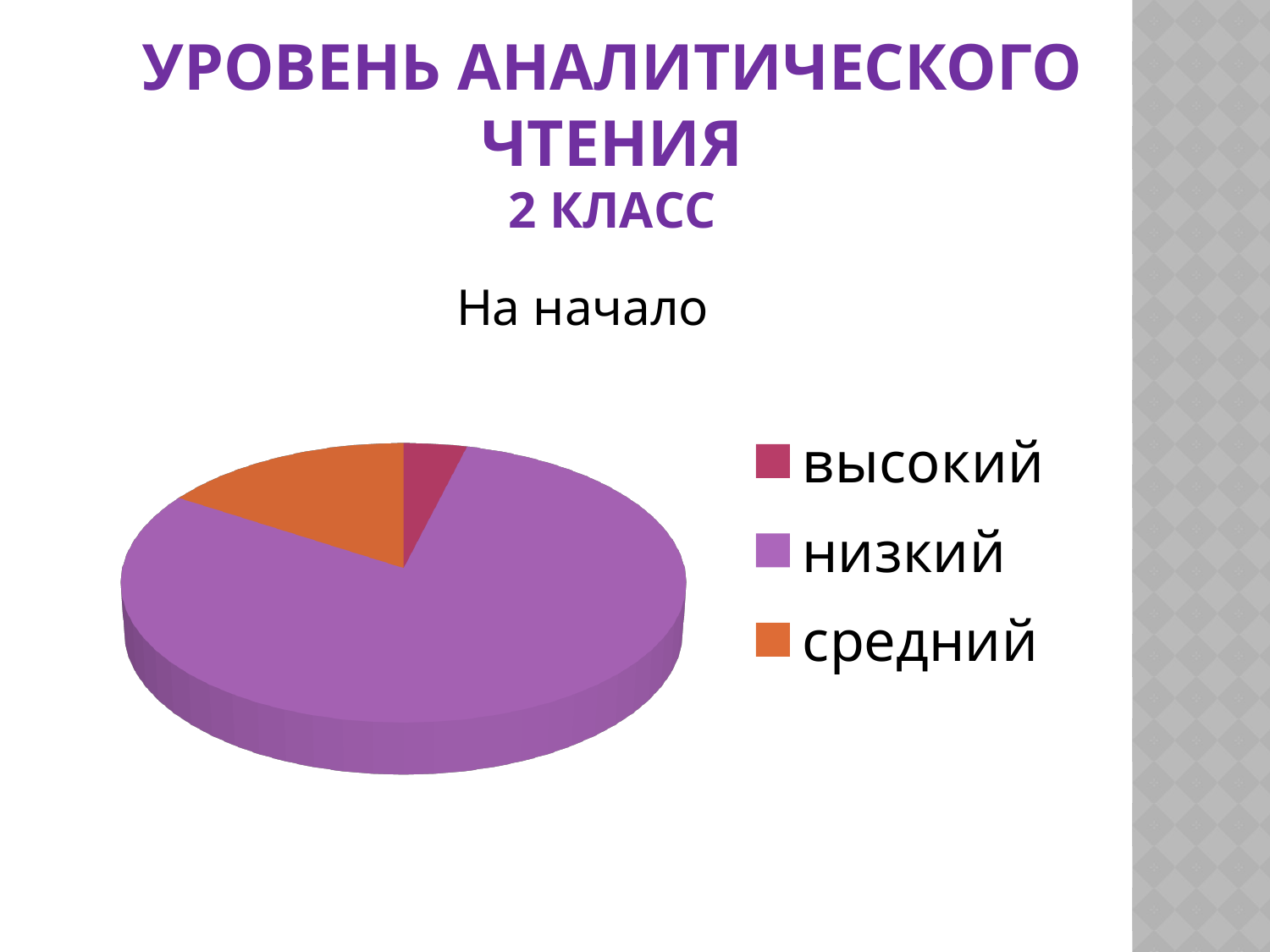
What kind of chart is shown on the slide? pie chart Which slice is larger, средний or высокий? средний How many slices does the pie chart have? 3 Which slice is larger, низкий or средний? низкий Which category has the smallest slice of the pie? высокий How many categories does the legend of the chart list? 3 What is the title of the chart? На начало What colour is the slice for средний? orange Which category is listed first in the legend? высокий Which category has the largest slice of the pie? низкий